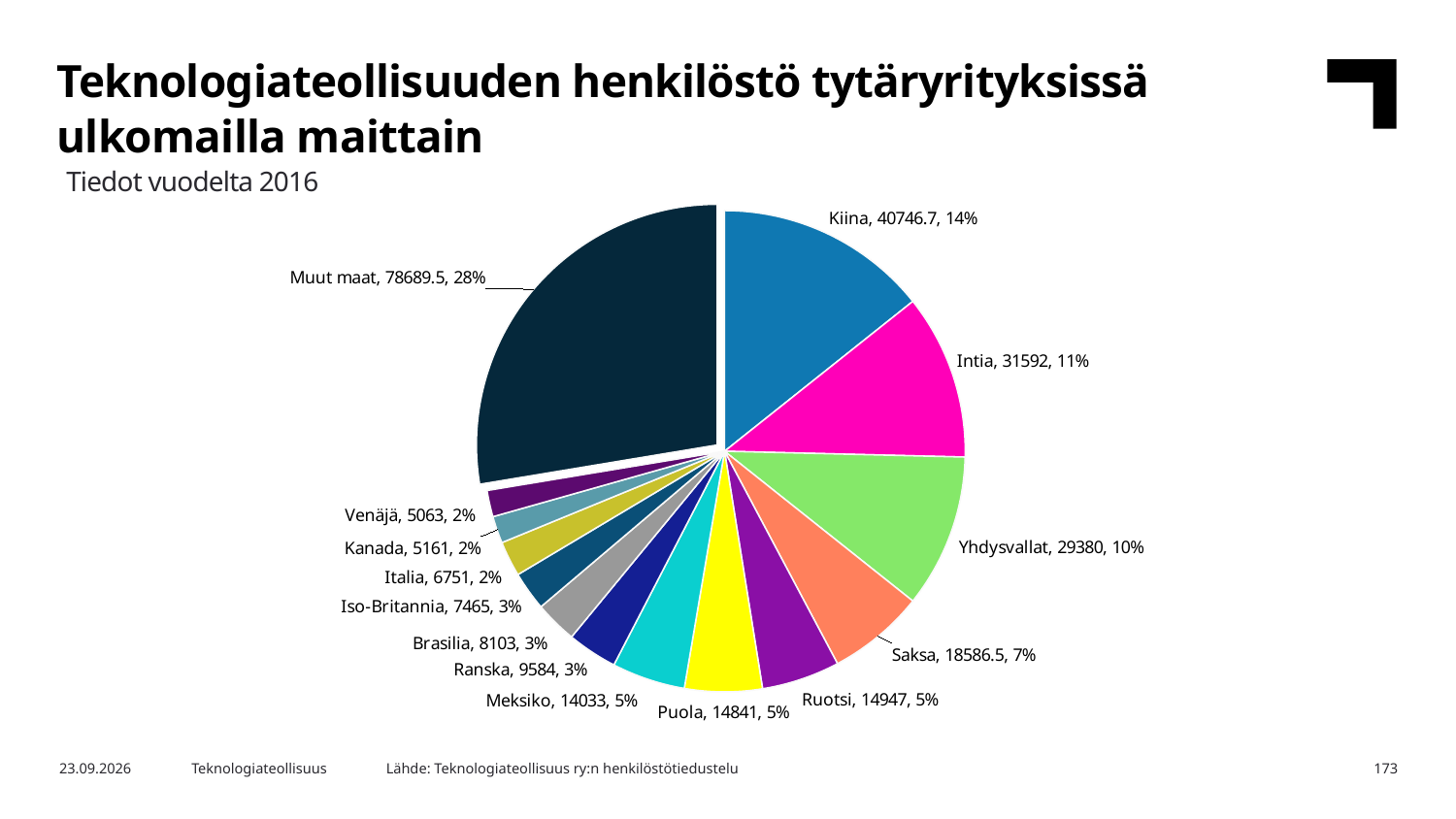
What is the difference between the values for Intia and Yhdysvallat? 2212 What share of the pie does Intia represent? 11% What is the value shown for Kiina? 40746.7 Which slice of the pie is the smallest? Venäjä Which slice of the pie is the largest? Muut maat What is the value shown for Meksiko? 14033 What year do the data on the slide refer to? 2016 What share of the pie does Muut maat represent? 28% How many slices does the pie chart have? 14 What type of chart is shown on the slide? Pie chart Which has a larger value, Ruotsi or Ranska? Ruotsi What is the value shown for Saksa? 18586.5